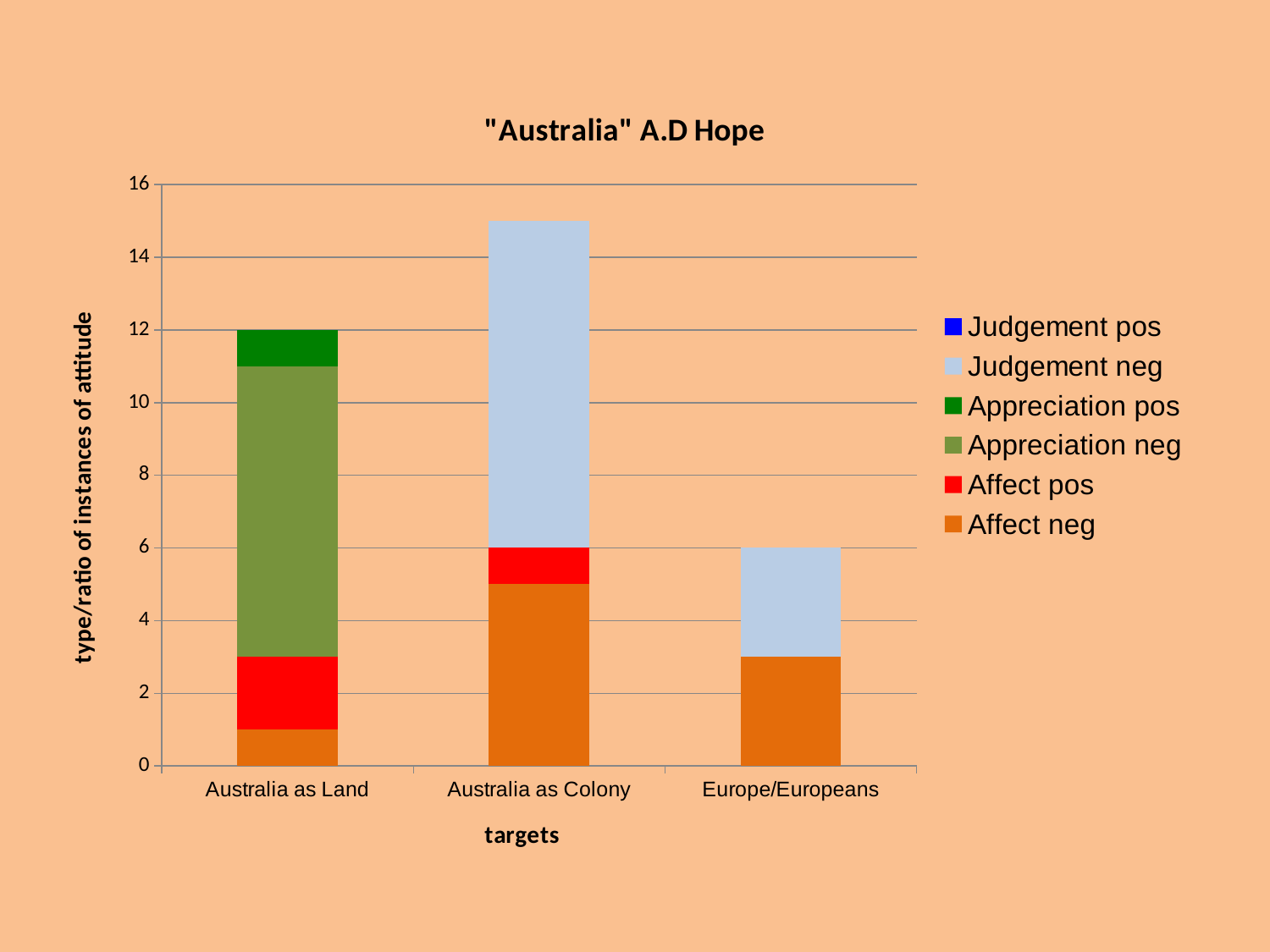
What is the total height of the stacked bar for Europe/Europeans? 6 Is the Affect neg value for Australia as Colony greater or less than 4? greater Is the total for Australia as Colony greater or less than 14? greater What is the title of the chart? "Australia" A.D Hope What is the difference between the total for Australia as Land and the total for Europe/Europeans? 6 Which target has the tallest stacked bar overall? Australia as Colony What is the total height of the stacked bar for Australia as Land? 12 What kind of chart is shown on the slide? Stacked bar chart How many target categories are shown on the x axis? 3 Which series is shown in red in the legend? Affect pos How many series does the legend list? 6 Which target has the shortest stacked bar overall? Europe/Europeans